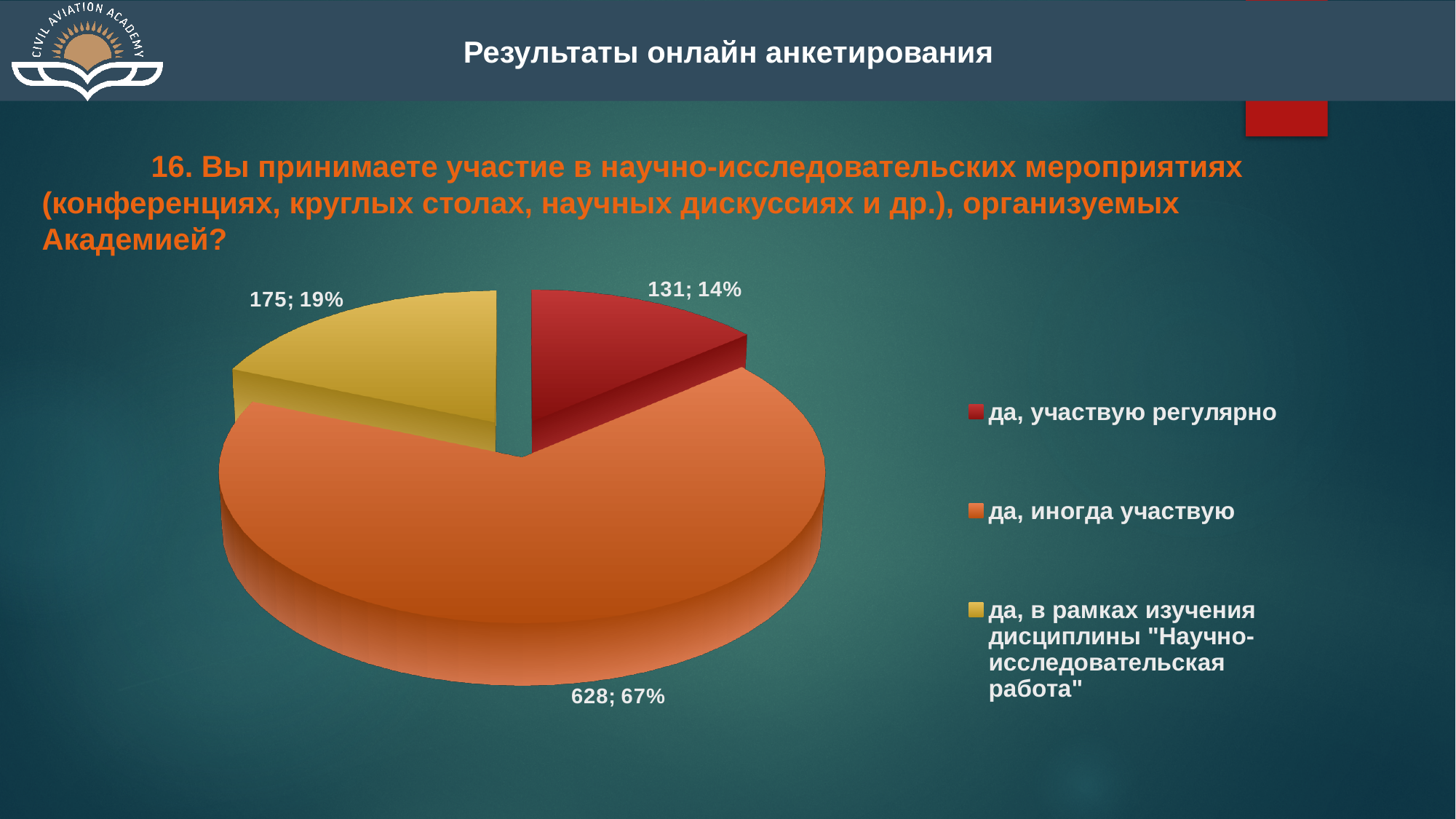
What kind of chart is shown on the slide? pie chart Which category has the smallest slice? да, участвую регулярно What is the value for "да, в рамках изучения дисциплины "Научно-исследовательская работа""? 175 Which category has the largest slice? да, иногда участвую What is the difference between the values for "да, иногда участвую" and "да, участвую регулярно"? 497 Which is larger: the value for "да, в рамках изучения дисциплины "Научно-исследовательская работа"" or "да, участвую регулярно"? да, в рамках изучения дисциплины "Научно-исследовательская работа" How many entries does the legend list? 3 What share of the pie does "да, участвую регулярно" represent? 14% What share of the pie does "да, иногда участвую" represent? 67% How many slices does the pie chart have? 3 What is the value for "да, иногда участвую"? 628 What is the value for "да, участвую регулярно"? 131